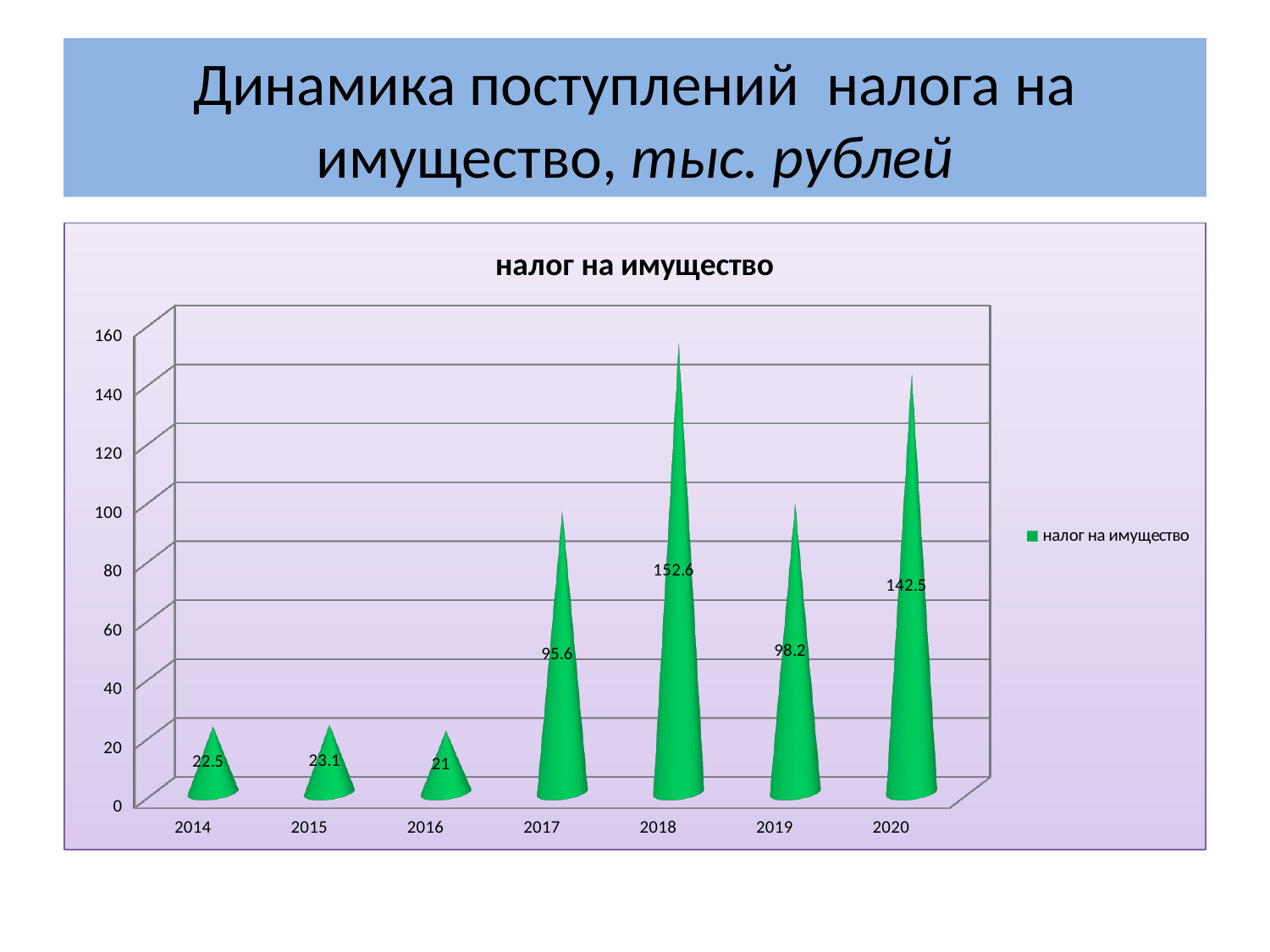
What is the value for 2020? 142.5 How many series does the legend list? 1 Which year has the lowest value? 2016 What is the value for 2014? 22.5 Is the value for 2019 greater or less than 100? less Which is larger, the value for 2017 or the value for 2019? 2019 What kind of chart is shown? bar chart What is the difference between the values for 2018 and 2020? 10.1 What is the value for 2018? 152.6 What is the title of the chart? налог на имущество How many years are shown on the x axis? 7 Which year has the highest value? 2018